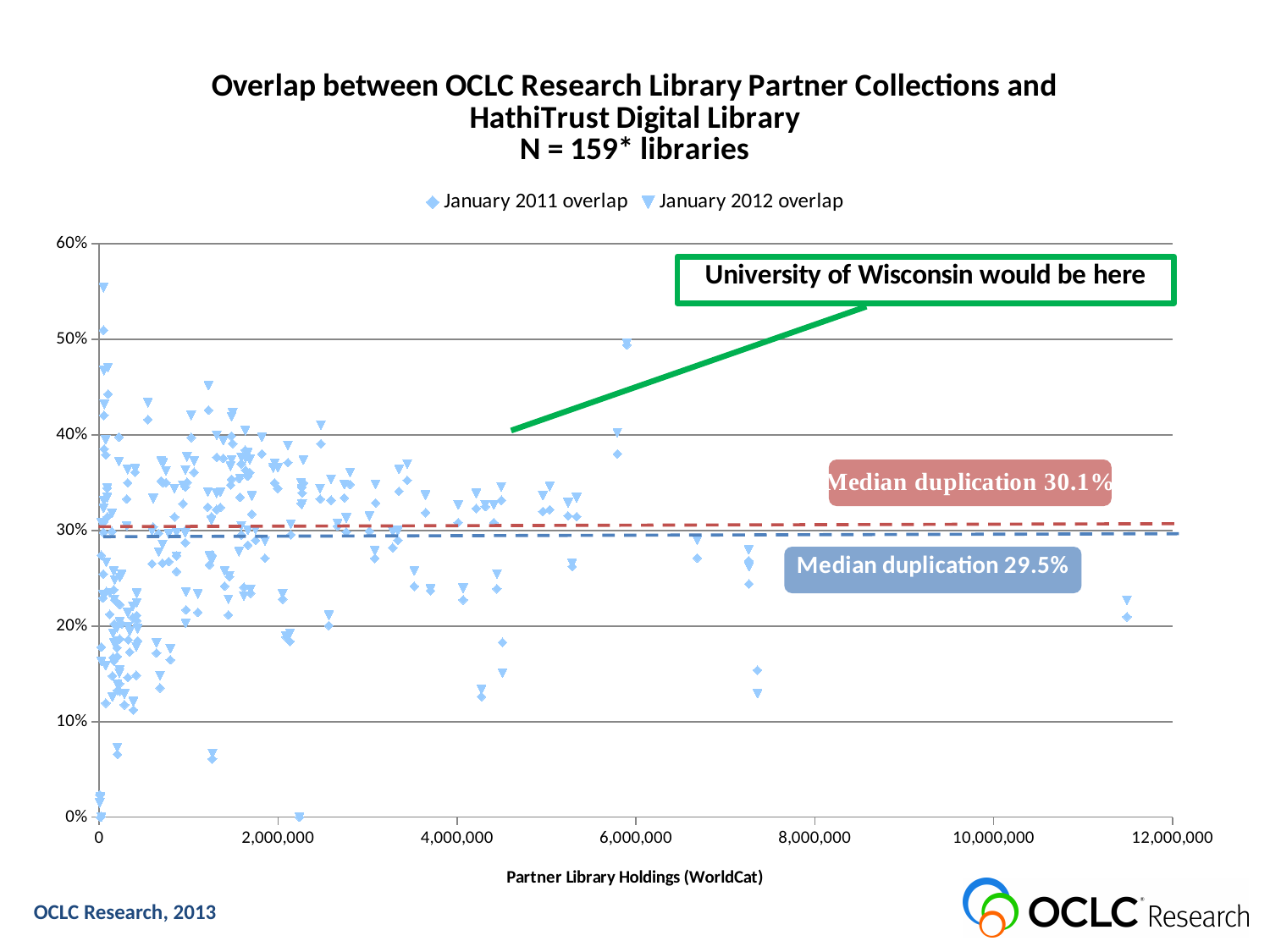
What median duplication value is shown in the blue label? 29.5% Is the overlap value for the points plotted at roughly 11,500,000 partner library holdings greater or less than 30%? less According to the chart title, how many libraries are included in the data? 159 How many series does the legend list? 2 What does the green annotation box on the chart say? University of Wisconsin would be here Is the highest point plotted near 6,000,000 partner library holdings greater or less than 40%? greater Which of the two median duplication values shown is larger, 30.1% or 29.5%? 30.1% What median duplication value is shown in the red label? 30.1% What is the difference between the two median duplication values shown on the chart? 0.6% What is the title of the x axis? Partner Library Holdings (WorldCat) What kind of chart is shown on the slide? scatter chart